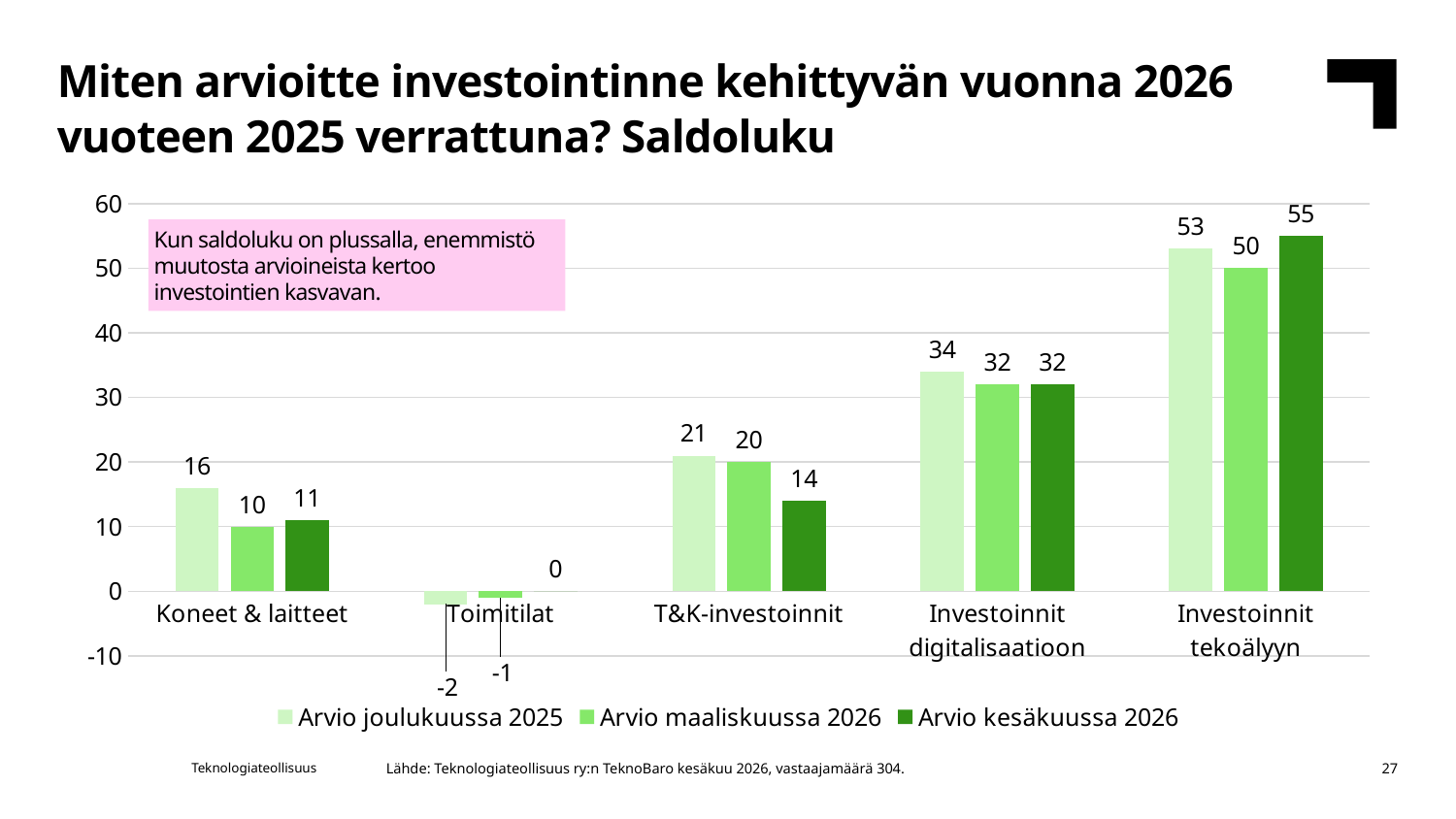
Which is larger for T&K-investoinnit: the Arvio joulukuussa 2025 value or the Arvio kesäkuussa 2026 value? Arvio joulukuussa 2025 What kind of chart is shown on the slide? Bar chart What is the difference between the Arvio kesäkuussa 2026 and Arvio maaliskuussa 2026 values for Investoinnit tekoälyyn? 5 Is the Arvio joulukuussa 2025 value for Investoinnit digitalisaatioon greater or less than 30? greater Which category has the lowest value in the Arvio joulukuussa 2025 series? Toimitilat What is the value for T&K-investoinnit in the Arvio kesäkuussa 2026 series? 14 How many series does the legend list? 3 What is the value for Koneet & laitteet in the Arvio joulukuussa 2025 series? 16 How many categories are shown on the x axis? 5 What is the value for Toimitilat in the Arvio maaliskuussa 2026 series? -1 What is the name of the third series in the legend? Arvio kesäkuussa 2026 Which category has the highest value in the Arvio kesäkuussa 2026 series? Investoinnit tekoälyyn